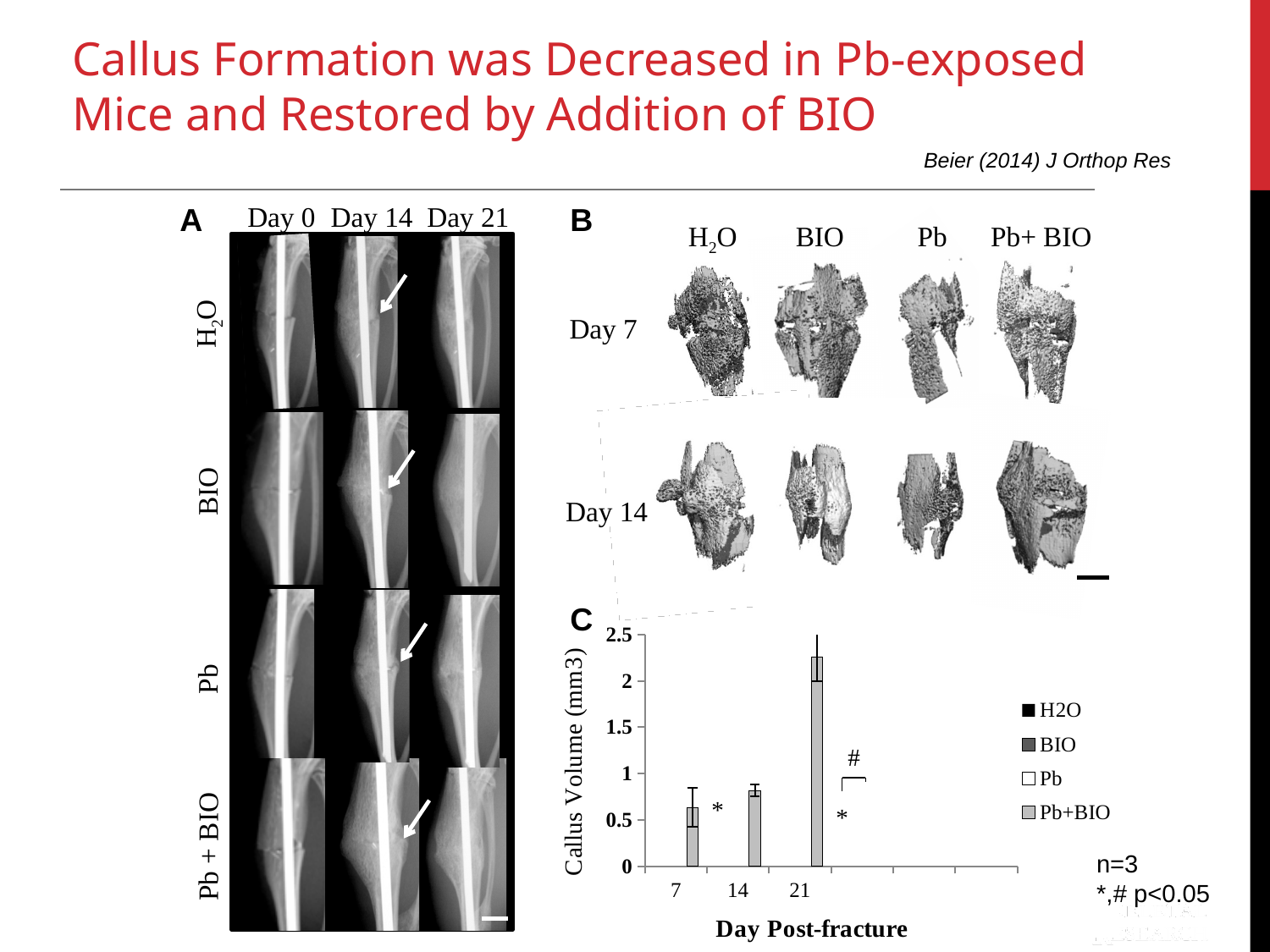
In the bar chart (panel C), which day post-fracture has the shortest bar? 7 In the bar chart (panel C), how many series does the legend list? 4 In the bar chart (panel C), is the bar at day 14 greater or less than 1 mm3? less In the bar chart (panel C), is the bar at day 7 greater or less than 1 mm3? less In the bar chart (panel C), how many day categories are shown on the x axis? 3 What is the y-axis title of the bar chart in panel C? Callus Volume (mm3) In the bar chart (panel C), is the bar at day 21 larger or smaller than the bar at day 7? larger What is the x-axis title of the bar chart in panel C? Day Post-fracture In the bar chart (panel C), which day post-fracture has the tallest bar? 21 In the bar chart (panel C), is the bar at day 21 greater or less than 2 mm3? greater What kind of chart is panel C on the slide? bar chart In the bar chart (panel C), do the bar heights rise or fall from day 7 to day 21? rise